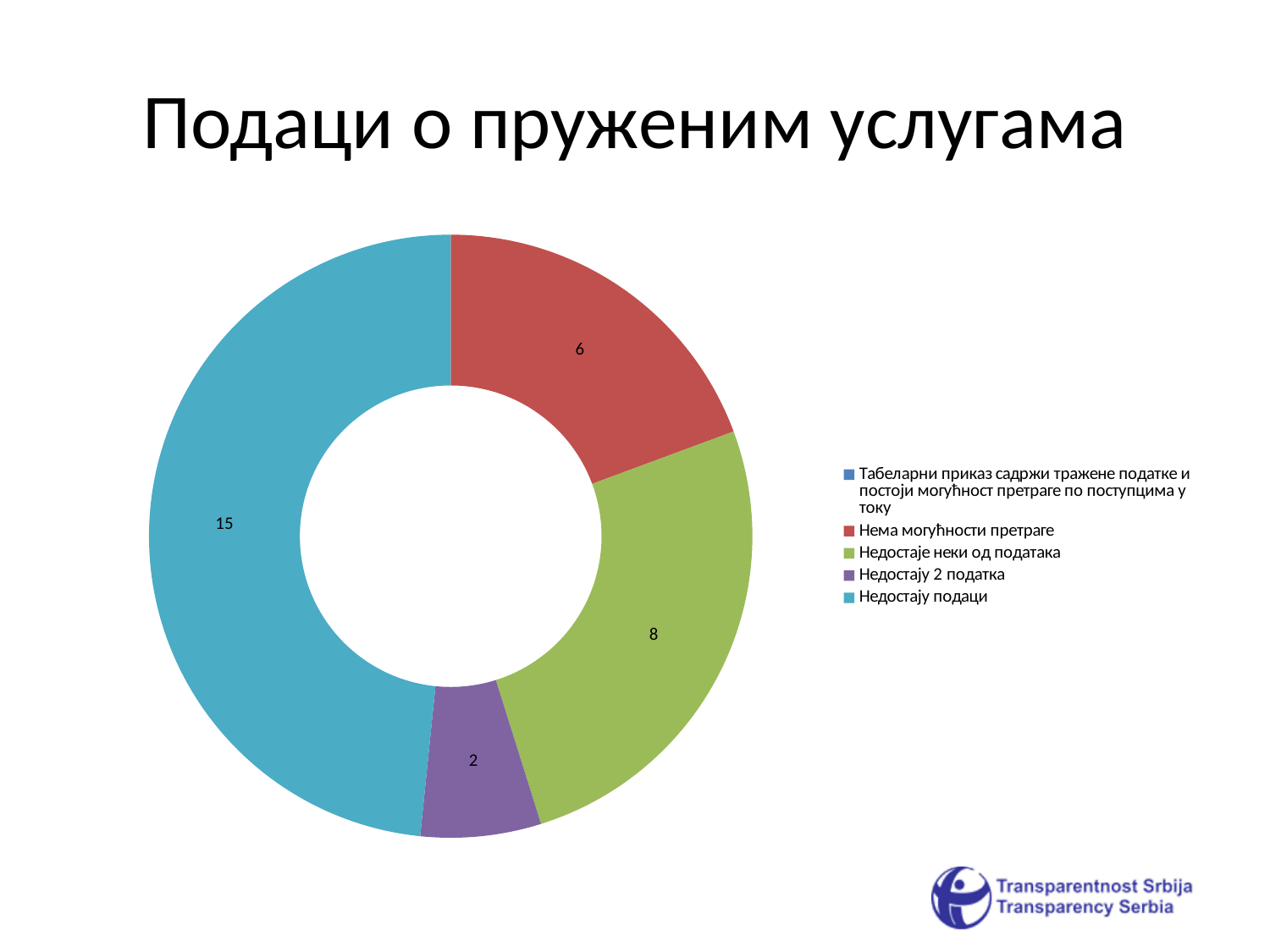
How many entries does the legend list? 5 What is the value for "Недостаје неки од података"? 8 What is the value for "Нема могућности претраге"? 6 What is the difference between the values for "Недостају подаци" and "Недостаје неки од података"? 7 Which category has the largest slice? Недостају подаци What is the value for "Недостају 2 податка"? 2 What type of chart is shown on the slide? doughnut chart Which is larger: the value for "Недостаје неки од података" or the value for "Нема могућности претраге"? Недостаје неки од података What is the value for "Недостају подаци"? 15 Which labelled slice has the smallest value? Недостају 2 податка What is the title of the slide? Подаци о пруженим услугама What is the difference between the values for "Нема могућности претраге" and "Недостају 2 податка"? 4